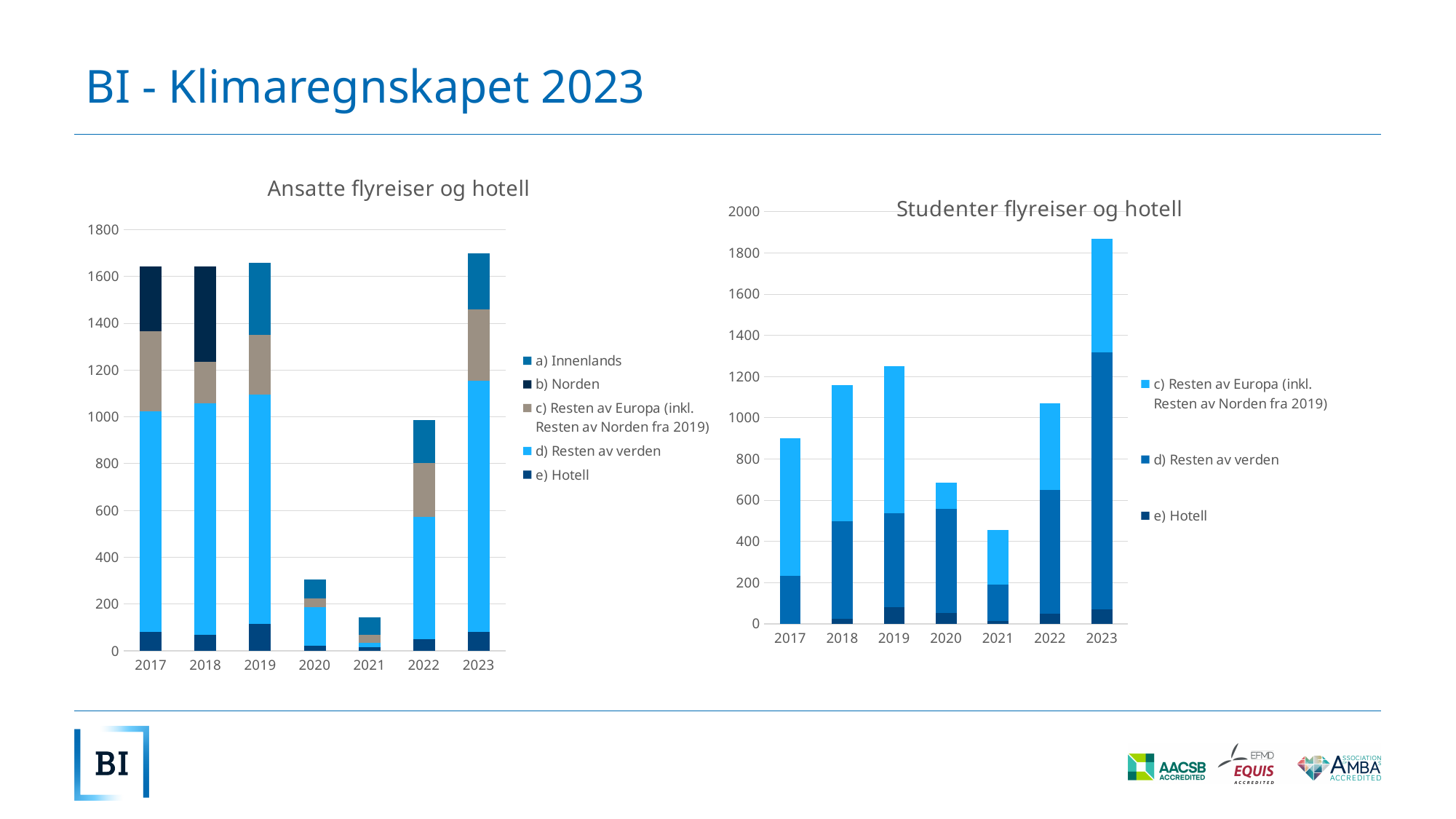
In the "Ansatte flyreiser og hotell" chart, is the total for 2021 greater or less than 200? less What kind of chart is the "Ansatte flyreiser og hotell" chart? Stacked bar chart How many years are shown on the x axis of the "Studenter flyreiser og hotell" chart? 7 In the "Studenter flyreiser og hotell" chart, which year has the highest total bar? 2023 In the "Ansatte flyreiser og hotell" chart, is the total for 2020 greater or less than 200? greater In the "Ansatte flyreiser og hotell" chart, which year has the lowest total bar? 2021 In the "Studenter flyreiser og hotell" chart, which year has the lowest total bar? 2021 Which series is shown in grey in the "Ansatte flyreiser og hotell" chart? c) Resten av Europa (inkl. Resten av Norden fra 2019) How many series does the legend of the "Studenter flyreiser og hotell" chart list? 3 In the "Studenter flyreiser og hotell" chart, is the total for 2023 greater or less than 1800? greater In the "Studenter flyreiser og hotell" chart, which year has the larger total bar, 2017 or 2022? 2022 How many series does the legend of the "Ansatte flyreiser og hotell" chart list? 5